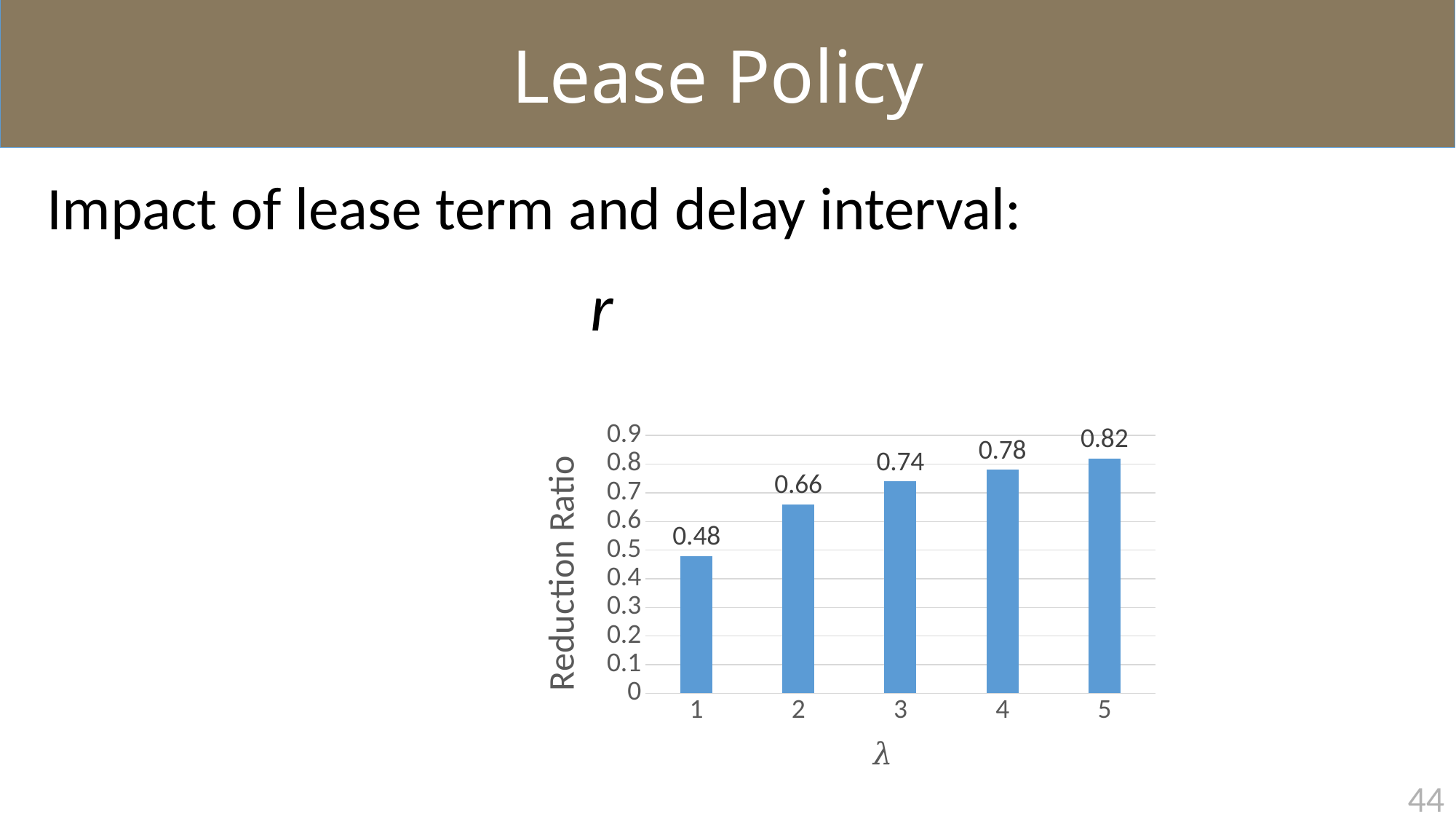
Which value of λ has the lowest Reduction Ratio? 1 What is the Reduction Ratio when λ is 1? 0.48 How many values of λ are plotted in the chart? 5 What is the Reduction Ratio when λ is 5? 0.82 Which value of λ has the highest Reduction Ratio? 5 What kind of chart is shown on the slide? bar chart What is the Reduction Ratio when λ is 3? 0.74 What is the difference in Reduction Ratio between λ = 2 and λ = 4? 0.12 Does the Reduction Ratio rise or fall as λ increases from 1 to 5? rise Which has a larger Reduction Ratio, λ = 2 or λ = 4? λ = 4 What is the difference in Reduction Ratio between λ = 5 and λ = 1? 0.34 Is the Reduction Ratio for λ = 1 greater or less than 0.5? less